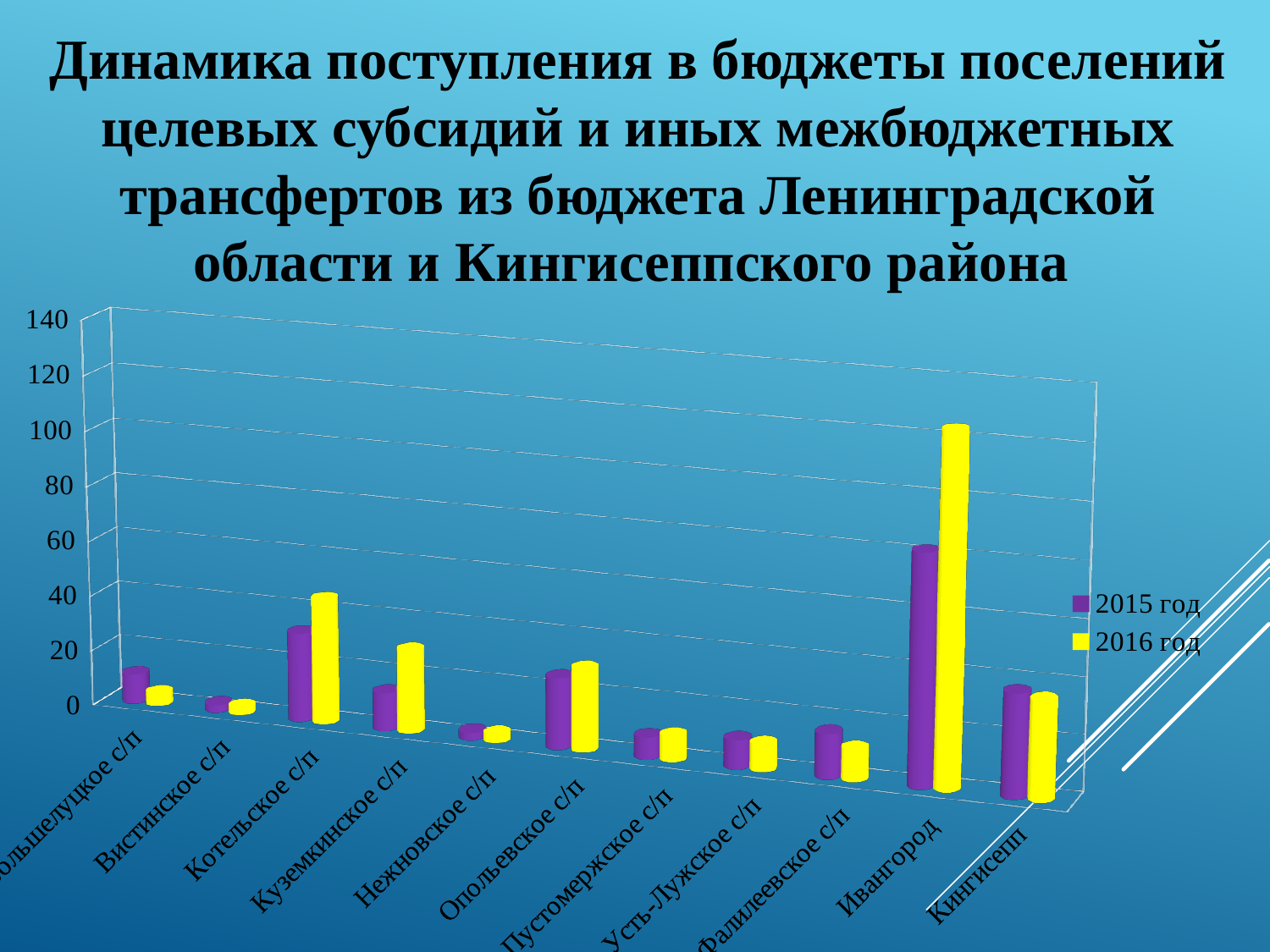
For Ивангород, which series has the larger value, 2015 год or 2016 год? 2016 год Is the 2016 год value for Ивангород greater or less than 80? greater How many series does the legend list? 2 Which category has the highest value for the 2015 год series? Ивангород Which category has the highest value for the 2016 год series? Ивангород Is the 2015 год value for Ивангород greater or less than 40? greater What colour are the bars for the 2016 год series? yellow For Куземкинское с/п, which series has the larger value, 2015 год or 2016 год? 2016 год What kind of chart is shown on the slide? bar chart Is the 2015 год value for Вистинское с/п greater or less than 20? less How many categories are shown along the x axis of the chart? 11